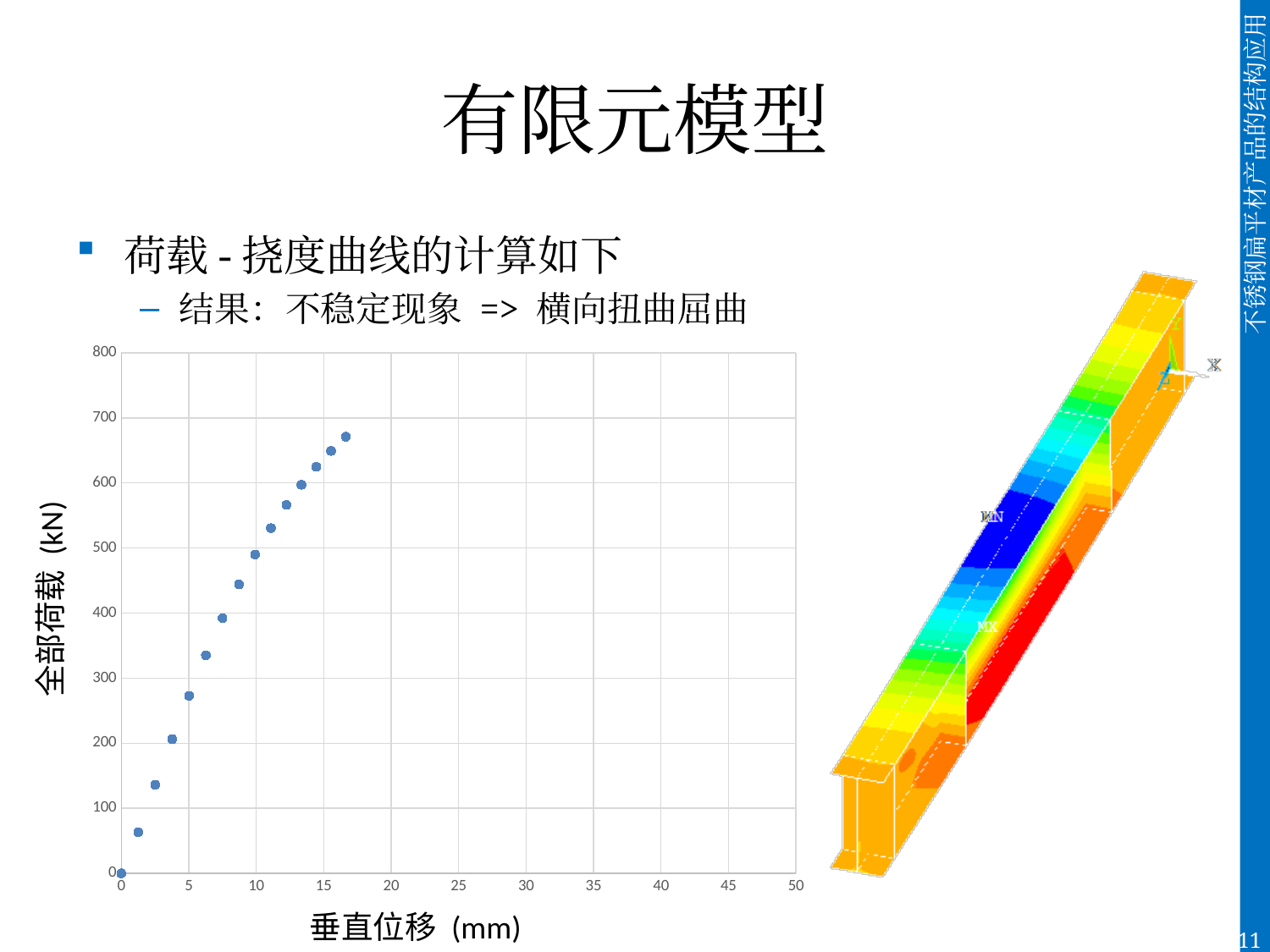
How many data points are plotted on the chart? 15 What is the title of the x axis of the chart? 垂直位移 (mm) What is the maximum value shown on the y axis of the chart? 800 Is the highest load value plotted on the chart greater or less than 700 kN? less Is the highest load value plotted on the chart greater or less than 600 kN? greater Is the largest vertical displacement plotted on the chart greater or less than 20 mm? less What kind of chart is shown on the slide? scatter chart Does the load rise or fall as the vertical displacement increases along the x axis? rise What is the title of the y axis of the chart? 全部荷载 (kN)